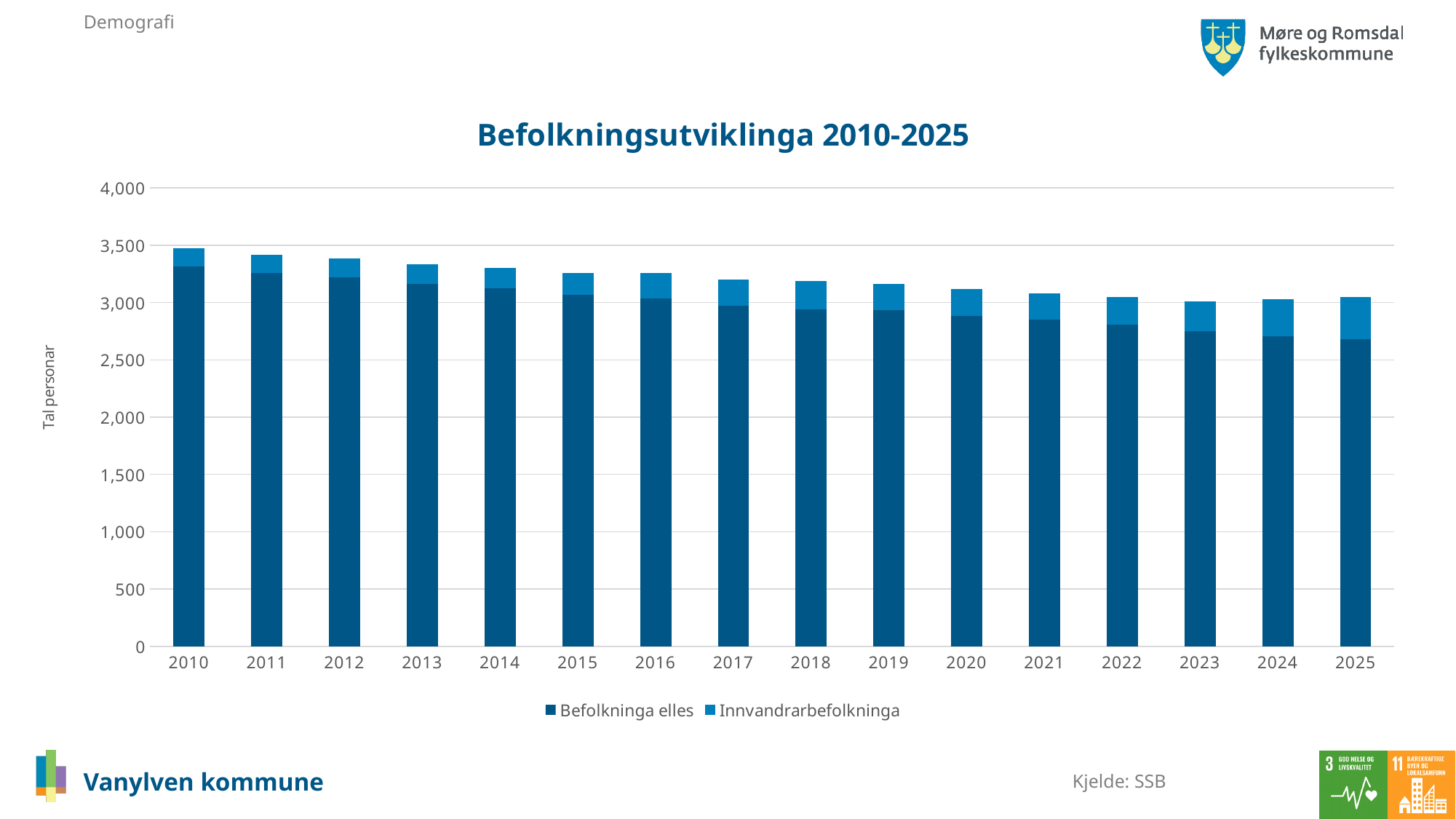
Which is larger, the total bar for 2010 or the total bar for 2025? 2010 Is the total bar for 2010 greater or less than 3,000? greater Which year has the highest total bar in the chart? 2010 Is the value for Befolkninga elles in 2025 greater or less than 3,000? less What is the label on the vertical axis of the chart? Tal personar What kind of chart is shown on the slide? bar chart What is the title of the chart? Befolkningsutviklinga 2010-2025 How many years are shown on the x axis of the chart? 16 Is the value for Befolkninga elles in 2020 greater or less than 3,000? less How many series does the chart's legend list? 2 Does the value for Befolkninga elles generally rise or fall from 2010 to 2025? fall